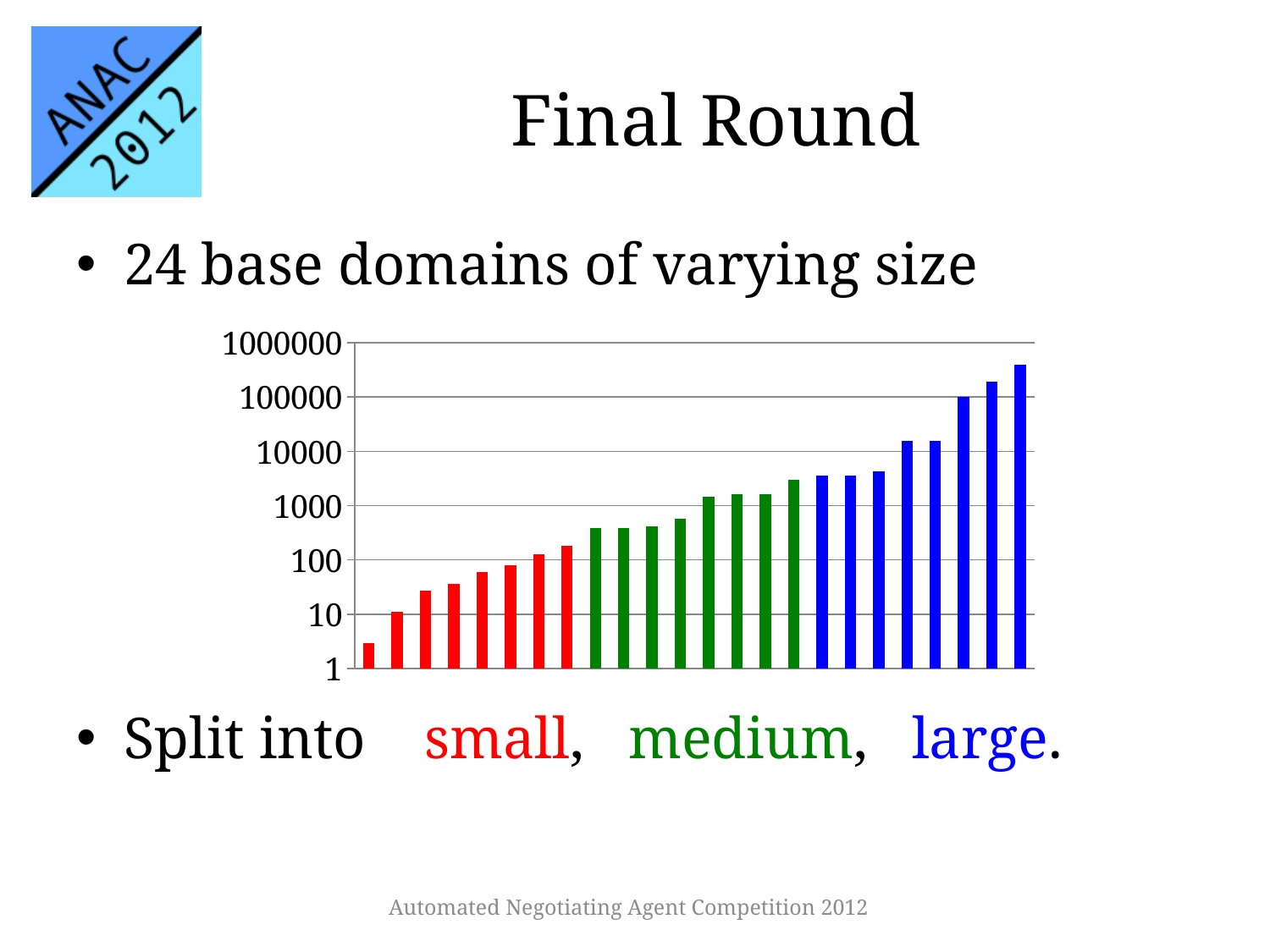
How many bars are plotted in the chart? 24 How many blue bars are there in the chart? 8 How many red bars are there in the chart? 8 Which bar is the lowest in the chart: the leftmost or the rightmost? the leftmost Is the value of the rightmost (last blue) bar greater or less than 100000? greater Do the bar values rise or fall from left to right across the chart? rise Is the value of the leftmost (first red) bar greater or less than 10? less Is the value of the first blue bar greater or less than 1000? greater Which bar is the highest in the chart: the leftmost or the rightmost? the rightmost What is the highest tick value shown on the vertical axis of the chart? 1000000 What kind of chart is shown on the slide? bar chart